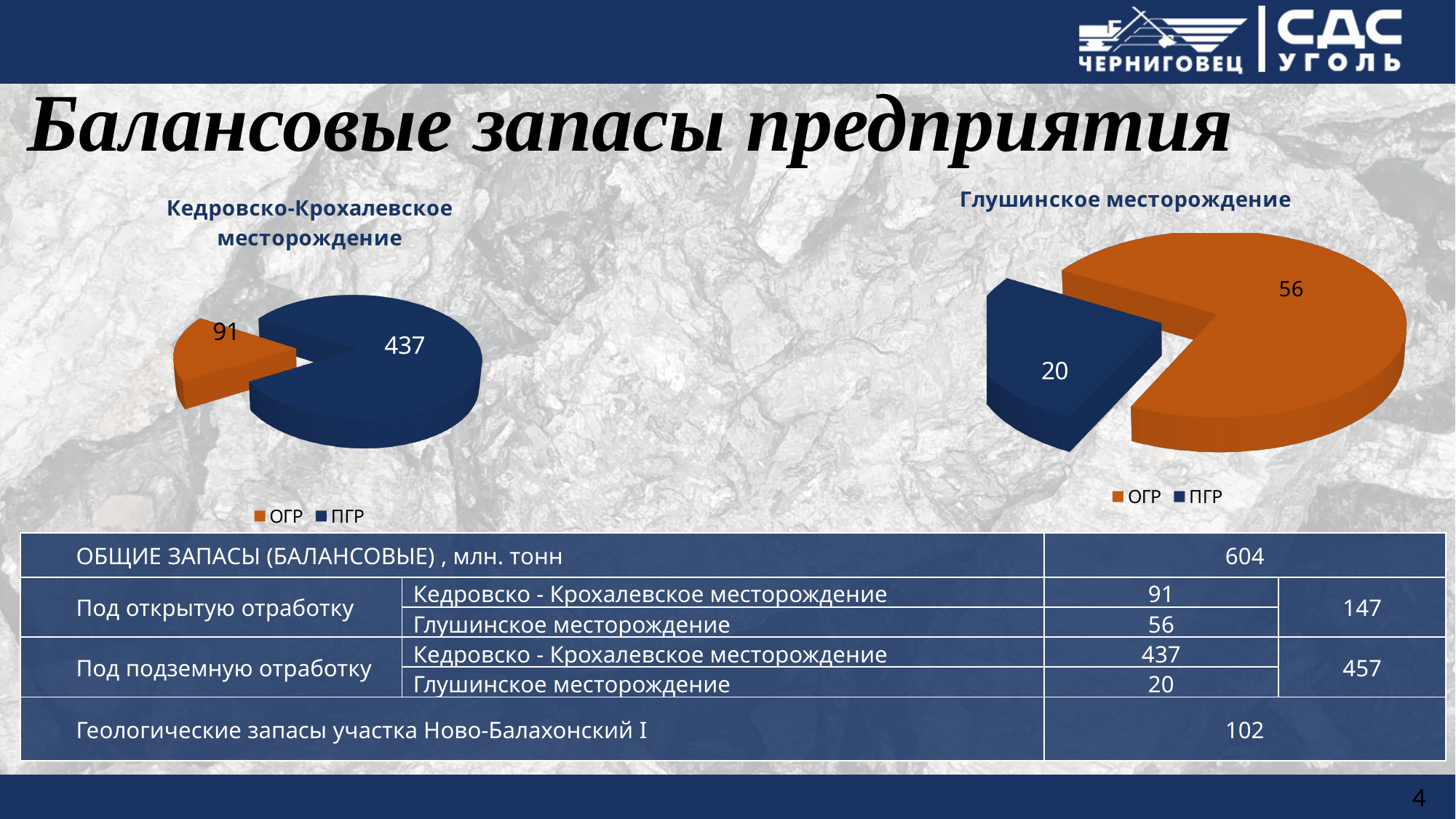
In the chart titled "Глушинское месторождение", which category has the smallest slice? ПГР In the chart titled "Кедровско-Крохалевское месторождение", what is the value for ПГР? 437 What type of chart is used for "Кедровско-Крохалевское месторождение"? Pie chart In the chart titled "Глушинское месторождение", which is larger, ОГР or ПГР? ОГР In the chart titled "Глушинское месторождение", what is the value for ПГР? 20 In the chart titled "Глушинское месторождение", what is the difference between the ОГР and ПГР values? 36 In the chart titled "Кедровско-Крохалевское месторождение", which category has the largest slice? ПГР How many series does the legend of the chart titled "Глушинское месторождение" list? 2 In the chart titled "Кедровско-Крохалевское месторождение", what colour is the ОГР slice? Orange In the chart titled "Кедровско-Крохалевское месторождение", what is the difference between the ПГР and ОГР values? 346 In the chart titled "Кедровско-Крохалевское месторождение", what is the value for ОГР? 91 In the chart titled "Глушинское месторождение", what is the value for ОГР? 56